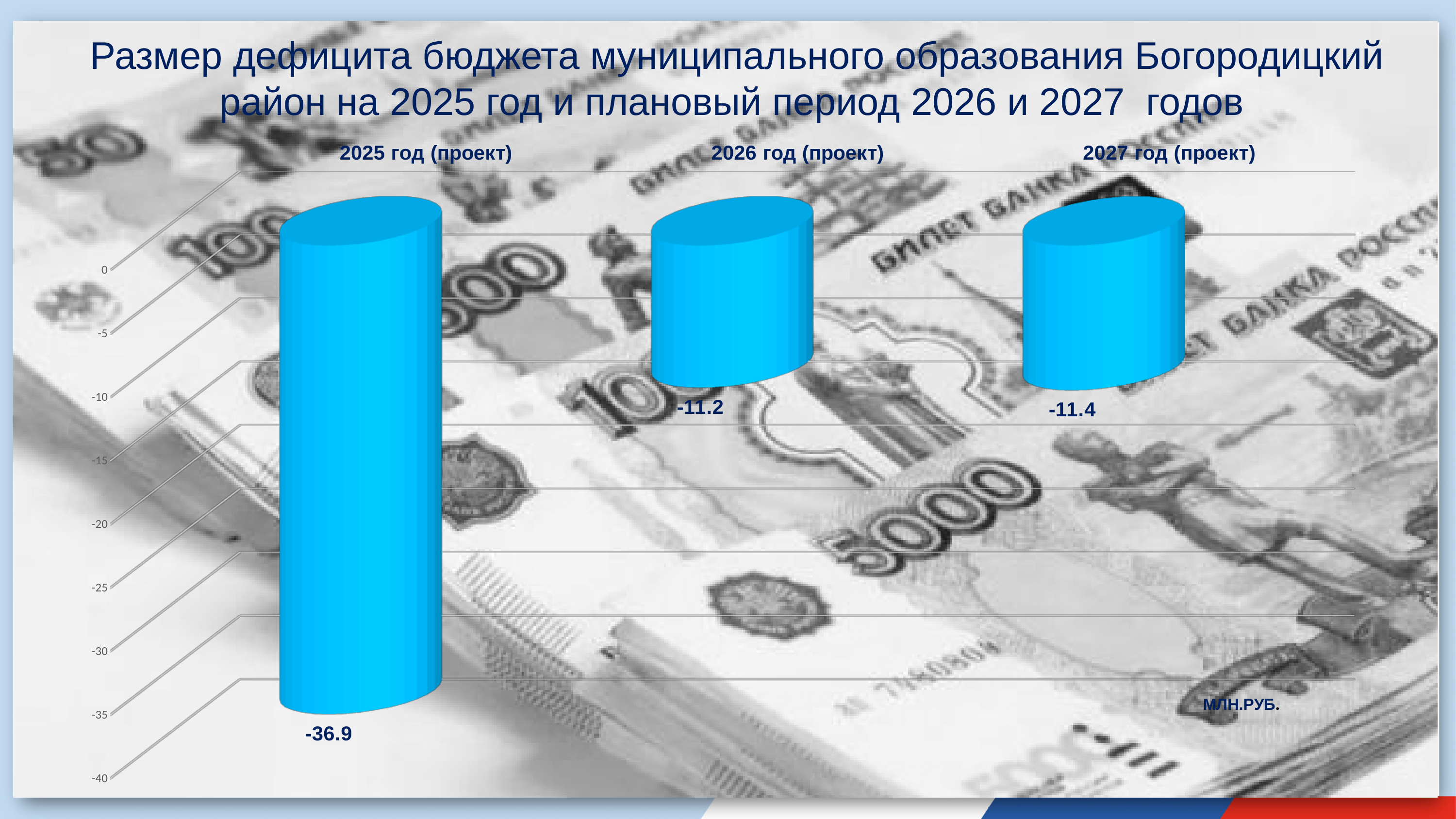
Which category has the lowest value? 2025 год (проект) What kind of chart is shown on the slide? bar chart How many categories are shown in the chart? 3 What is the difference between the values for 2027 год (проект) and 2026 год (проект)? 0.2 What is the value for 2027 год (проект)? -11.4 Is the value for 2025 год (проект) greater or less than -30? less What is the value for 2026 год (проект)? -11.2 Which is larger, the value for 2026 год (проект) or the value for 2027 год (проект)? 2026 год (проект) What is the value for 2025 год (проект)? -36.9 Which category has the highest value? 2026 год (проект) What unit label is shown in the lower right of the chart? млн.руб. What is the difference between the values for 2025 год (проект) and 2026 год (проект)? 25.7